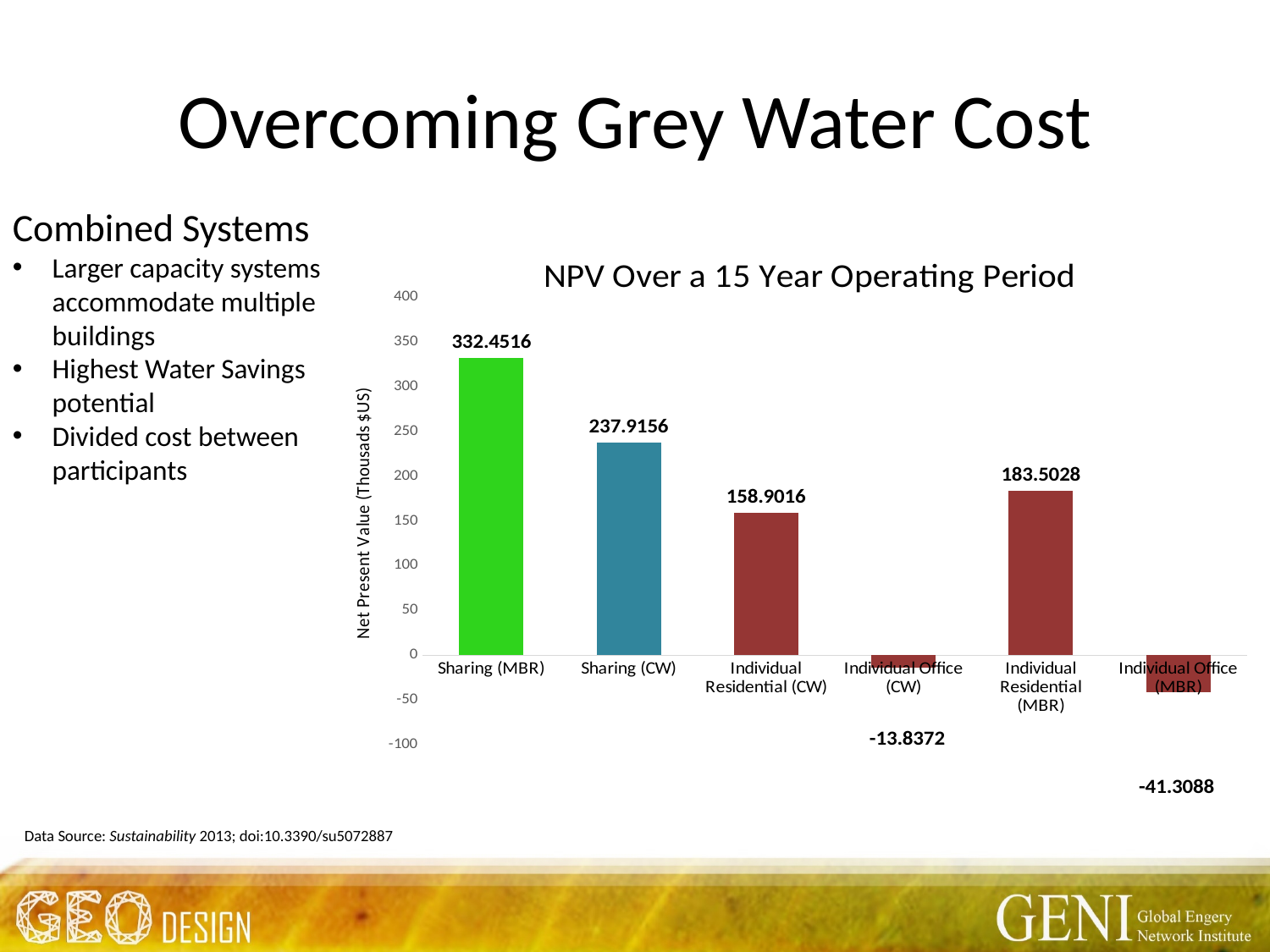
What is the difference between the values for Sharing (MBR) and Sharing (CW)? 94.536 Which is larger, the value for Sharing (CW) or the value for Individual Residential (MBR)? Sharing (CW) What is the value for Individual Office (CW)? -13.8372 Which category has the highest NPV? Sharing (MBR) Which category has the lowest NPV? Individual Office (MBR) What is the value for Individual Residential (CW)? 158.9016 What is the value for Individual Office (MBR)? -41.3088 What is the value for Sharing (MBR)? 332.4516 How many categories are shown on the x axis? 6 What is the difference between the values for Individual Residential (MBR) and Individual Residential (CW)? 24.6012 What kind of chart is shown? Bar chart What is the title of the chart? NPV Over a 15 Year Operating Period